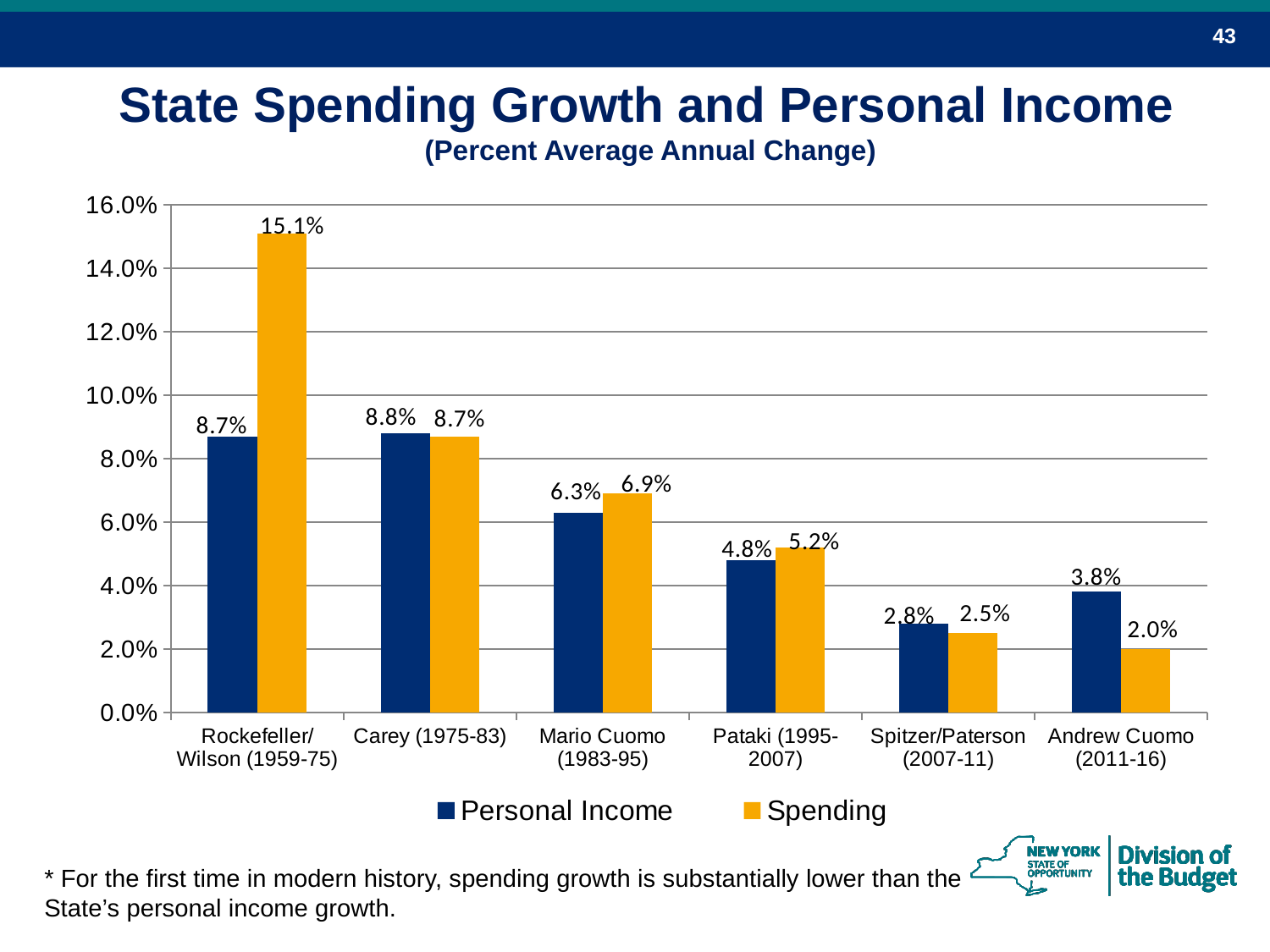
What is the Spending value for Rockefeller/Wilson (1959-75)? 15.1% How many governor periods are shown on the x axis? 6 Which governor period has the highest Spending value? Rockefeller/Wilson (1959-75) Which governor period has the lowest Spending value? Andrew Cuomo (2011-16) For Mario Cuomo (1983-95), which is larger: Personal Income or Spending? Spending Is the Spending value for Rockefeller/Wilson (1959-75) greater or less than 14.0%? greater What is the Spending value for Pataki (1995-2007)? 5.2% How many series does the legend list? 2 What is the difference between the Personal Income and Spending values for Andrew Cuomo (2011-16)? 1.8% What kind of chart is shown on the slide? Bar chart What is the difference between the Spending and Personal Income values for Rockefeller/Wilson (1959-75)? 6.4% What is the Personal Income value for Andrew Cuomo (2011-16)? 3.8%